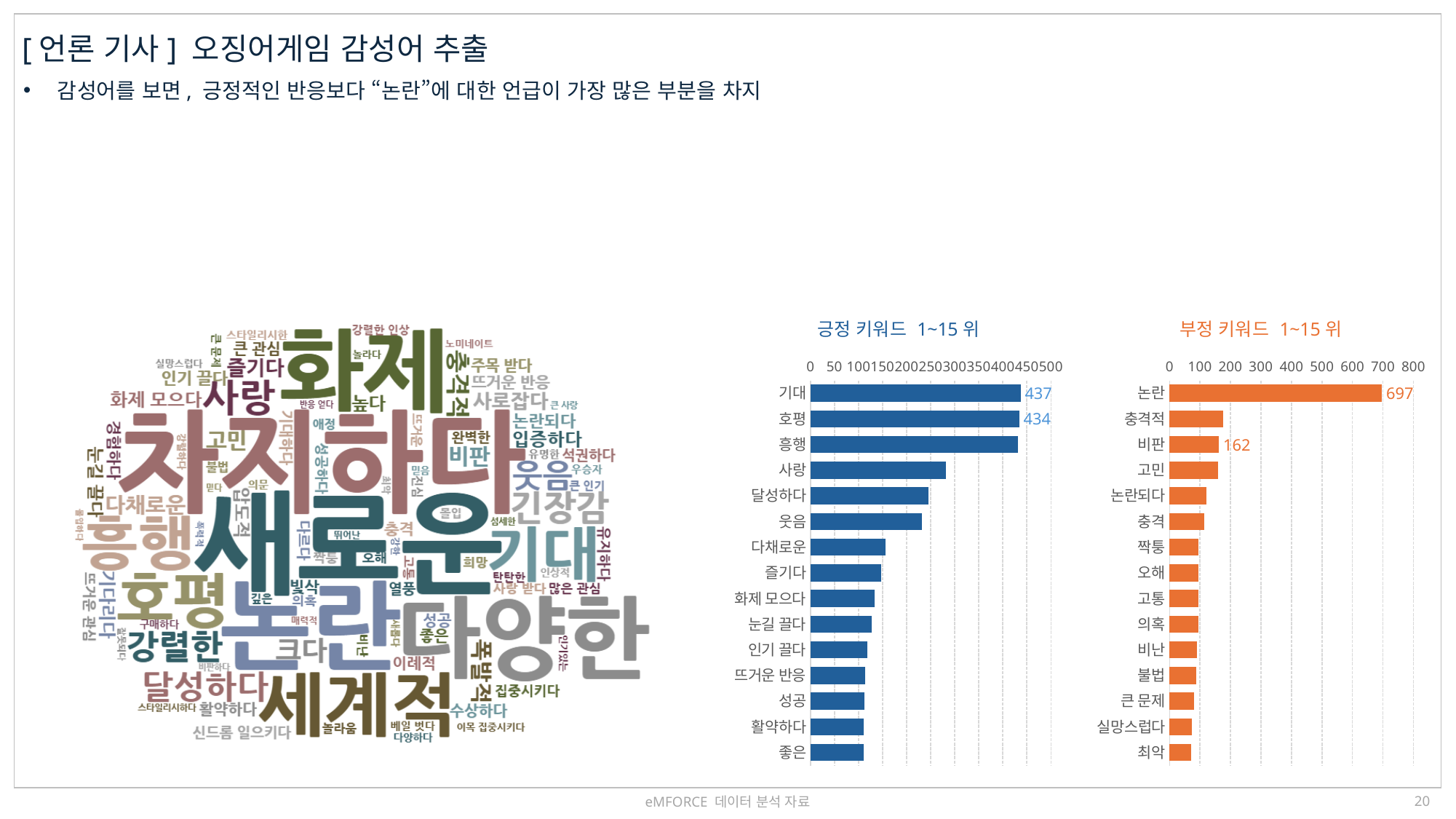
In the 부정 키워드 1~15 위 chart, what is the value for 비판? 162 What kind of chart is the 부정 키워드 1~15 위 chart? Bar chart How many keywords are shown in the 긍정 키워드 1~15 위 chart? 15 In the 긍정 키워드 1~15 위 chart, what is the value for 기대? 437 Which is larger: the value for 논란 in the 부정 키워드 chart or the value for 기대 in the 긍정 키워드 chart? 논란 In the 긍정 키워드 1~15 위 chart, what is the difference between the values for 기대 and 호평? 3 In the 부정 키워드 1~15 위 chart, what is the difference between the values for 논란 and 비판? 535 In the 부정 키워드 1~15 위 chart, which keyword has the highest value? 논란 In the 부정 키워드 1~15 위 chart, what is the value for 논란? 697 In the 부정 키워드 1~15 위 chart, is the value for 충격적 greater or less than 300? less In the 긍정 키워드 1~15 위 chart, is the value for 사랑 greater or less than 350? less In the 긍정 키워드 1~15 위 chart, what is the value for 호평? 434